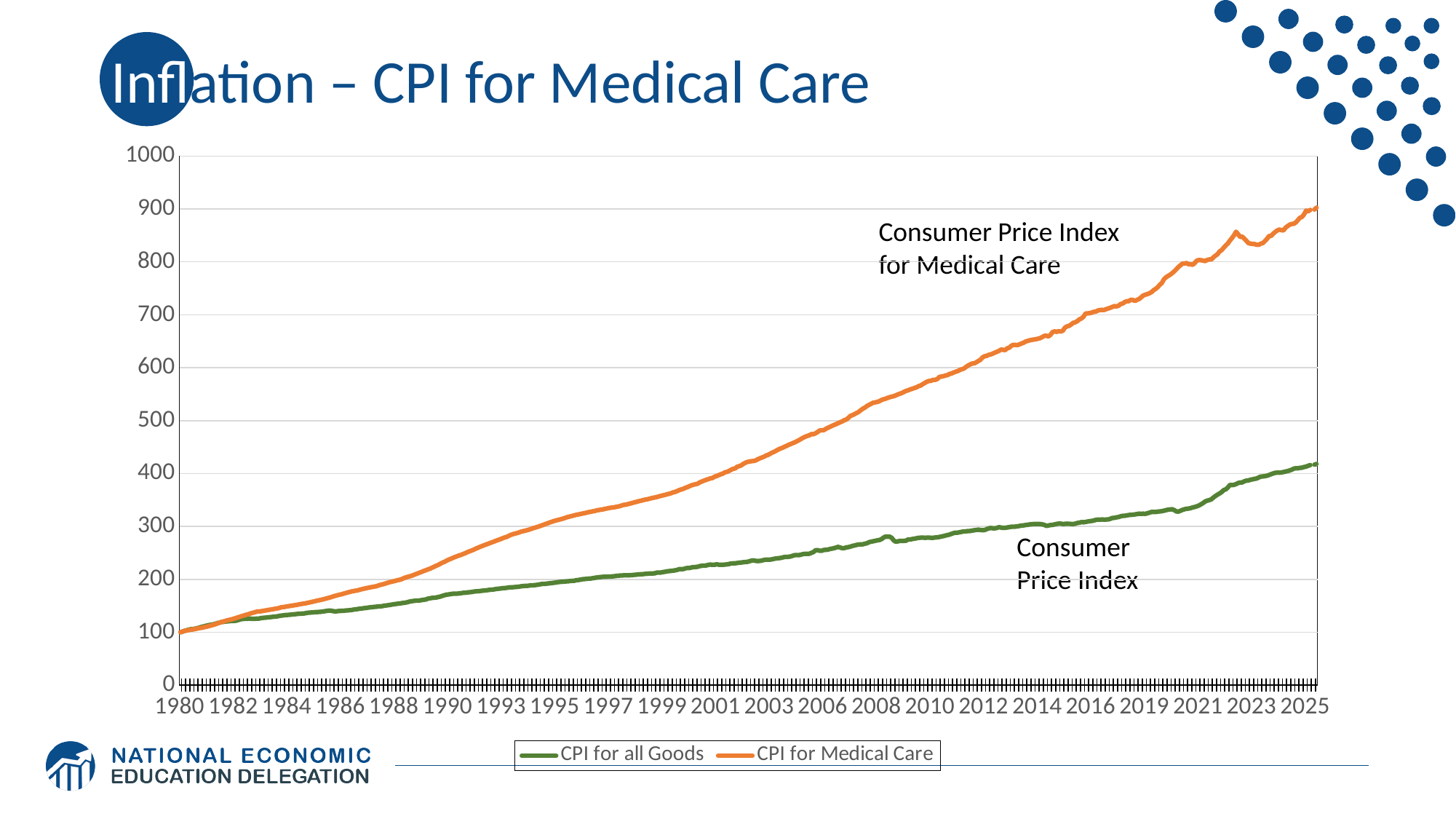
How many series does the legend list? 2 Is the value for CPI for Medical Care in 1990 greater or less than 300? less Does the CPI for Medical Care line rise or fall from 1980 to 2025? rise Is the value for CPI for Medical Care in 2025 greater or less than 800? greater Is the value for CPI for all Goods in 2010 greater or less than 300? less What kind of chart is shown on the slide? line chart What colour is the CPI for Medical Care line? orange Which series is higher in 2025, CPI for all Goods or CPI for Medical Care? CPI for Medical Care What value do both series start at in 1980? 100 What is the title of the slide? Inflation – CPI for Medical Care